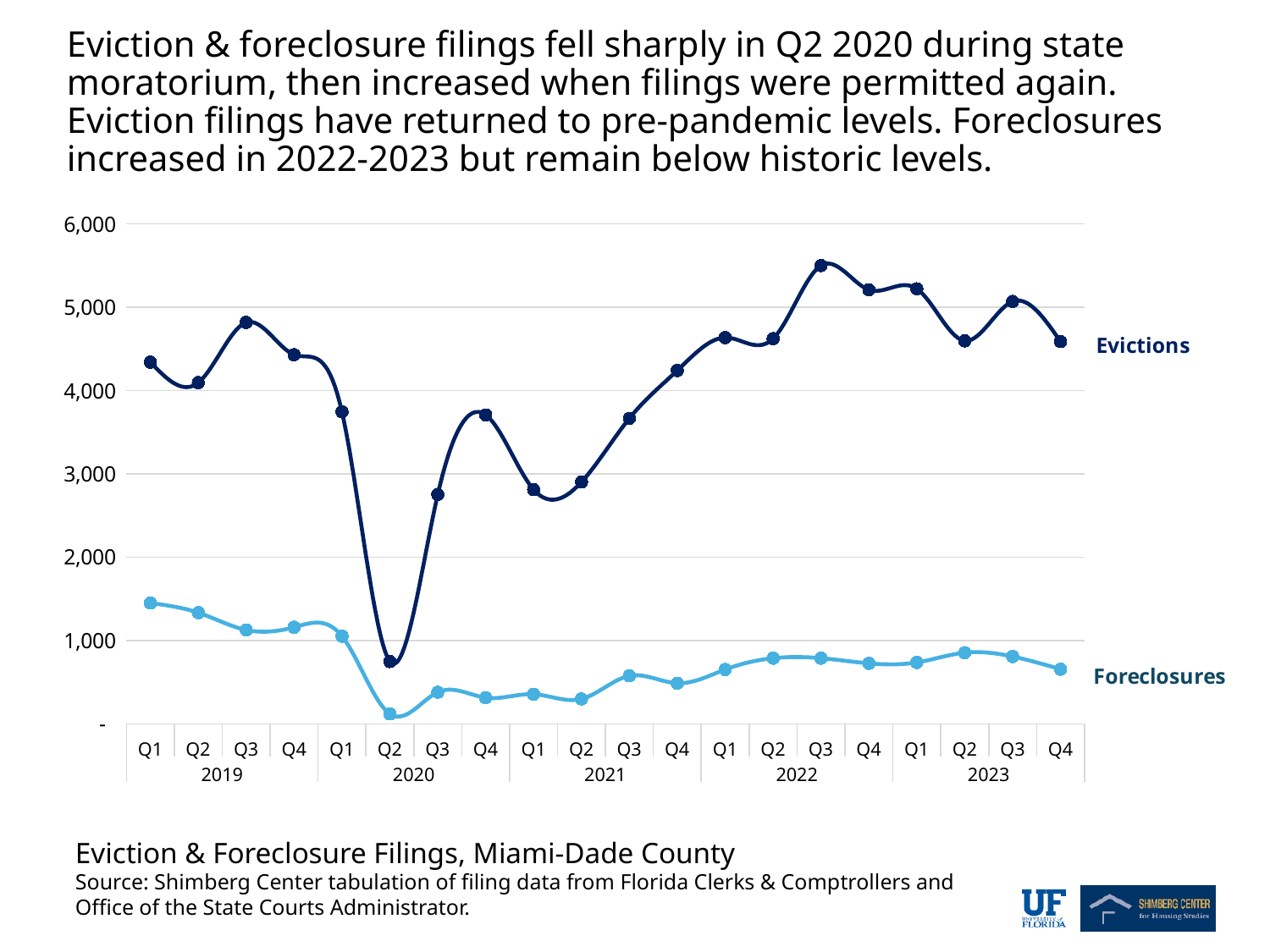
Is the value for Foreclosures in Q1 2019 greater or less than 1,000? greater Do Evictions rise or fall from Q2 2020 to Q3 2022? rise In which quarter do Foreclosures reach their lowest value? Q2 2020 In which quarter do Evictions reach their highest value? Q3 2022 Is the value for Evictions in Q2 2020 greater or less than 1,000? less In which quarter do Evictions reach their lowest value? Q2 2020 How many series are plotted on the chart? 2 What is the title of the chart? Eviction & Foreclosure Filings, Miami-Dade County Is the value for Evictions in Q3 2022 greater or less than 5,000? greater How many quarterly data points does each line have? 20 What kind of chart is shown on the slide? line chart Which is larger: Evictions in Q2 2019 or Evictions in Q3 2019? Q3 2019